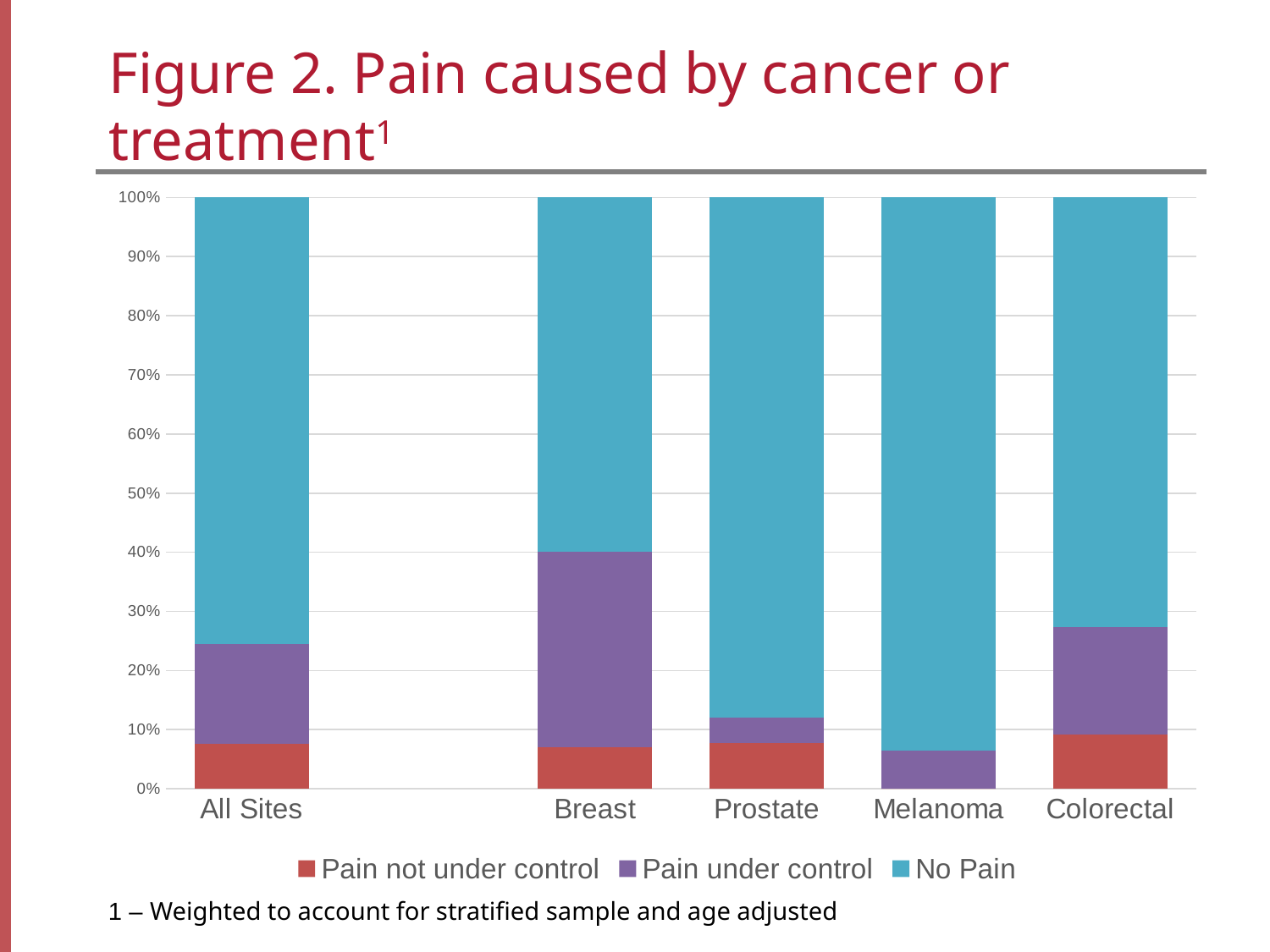
Which category has the smallest No Pain share? Breast How many cancer site categories are shown on the x axis? 5 Which category has the largest Pain under control segment? Breast How many series does the legend list? 3 What kind of chart is shown on the slide? Stacked bar chart Is the top of the Pain under control segment for Colorectal greater or less than 20%? greater Is the Pain under control segment larger for Breast or for Prostate? Breast Is the top of the Pain under control segment for Breast greater or less than 30%? greater Which category has the largest No Pain share? Melanoma Which series is shown in blue in the legend? No Pain Is the Pain not under control segment larger for Colorectal or for Melanoma? Colorectal Is the top of the Pain under control segment for Melanoma greater or less than 10%? less